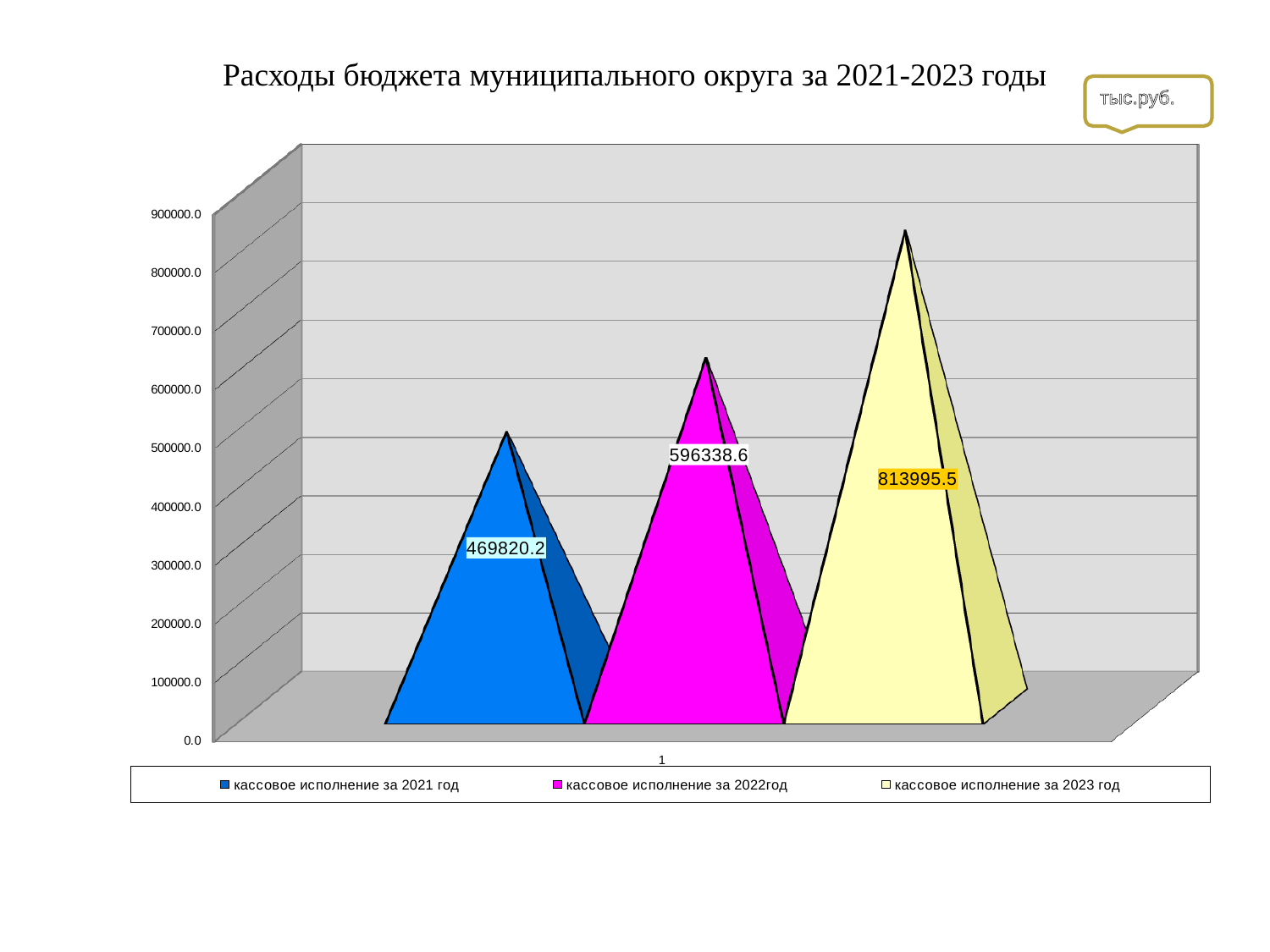
What is the title of the chart? Расходы бюджета муниципального округа за 2021-2023 годы Is the value for кассовое исполнение за 2023 год greater or less than 800000.0? greater What is the value for кассовое исполнение за 2021 год? 469820.2 Which is larger, the value for 2022 or the value for 2023? кассовое исполнение за 2023 год Which series has the lowest value? кассовое исполнение за 2021 год How many series does the legend list? 3 What is the value for кассовое исполнение за 2023 год? 813995.5 What is the difference between the values for 2023 and 2021? 344175.3 What is the difference between the values for 2022 and 2021? 126518.4 What is the value for кассовое исполнение за 2022год? 596338.6 Which series has the highest value? кассовое исполнение за 2023 год What kind of chart is shown on the slide? bar chart